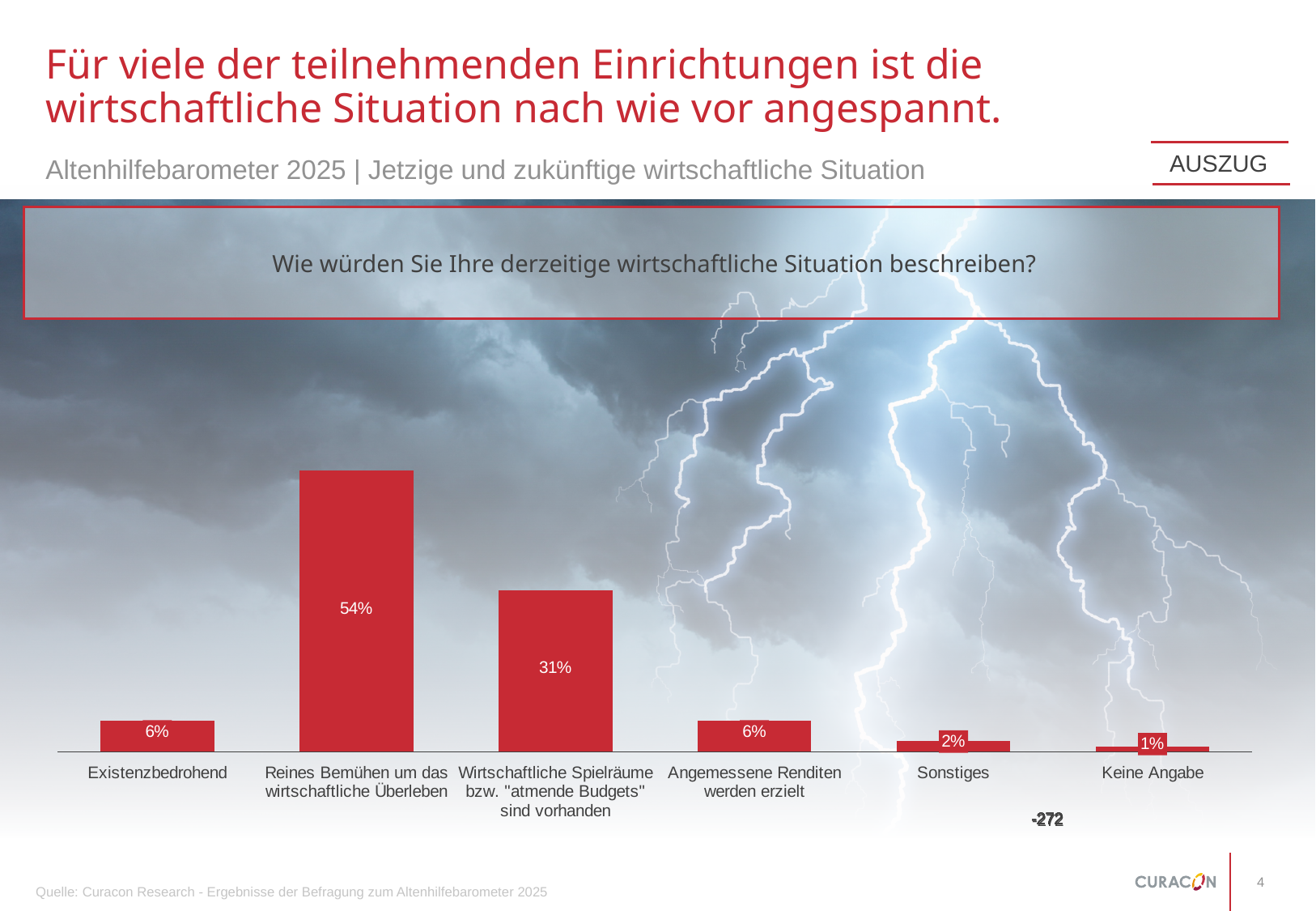
What is the difference between the values for "Reines Bemühen um das wirtschaftliche Überleben" and "Wirtschaftliche Spielräume bzw. "atmende Budgets" sind vorhanden"? 23 percentage points Which is larger: the value for "Angemessene Renditen werden erzielt" or the value for "Sonstiges"? Angemessene Renditen werden erzielt What value is shown for "Reines Bemühen um das wirtschaftliche Überleben"? 54% What percentage of respondents described their economic situation as "Existenzbedrohend"? 6% Which category has the lowest value? Keine Angabe Which category has the highest value? Reines Bemühen um das wirtschaftliche Überleben What percentage is shown for "Wirtschaftliche Spielräume bzw. "atmende Budgets" sind vorhanden"? 31% What value is shown for "Keine Angabe"? 1% What kind of chart is shown on the slide? Bar chart What question is the chart based on, as shown in the box above it? Wie würden Sie Ihre derzeitige wirtschaftliche Situation beschreiben? How many categories are shown in the chart? 6 What value is shown for "Sonstiges"? 2%